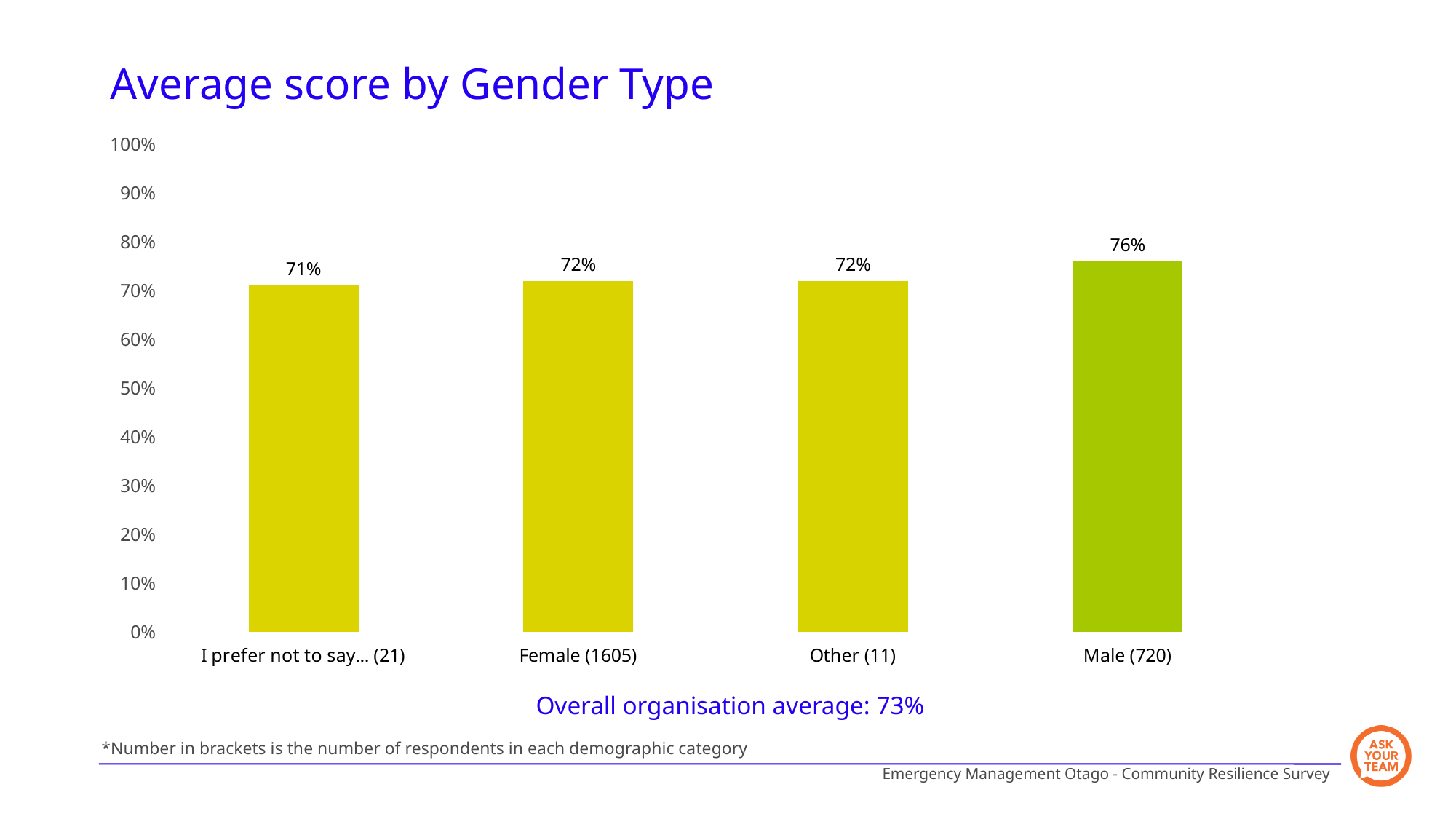
What is the average score for Female (1605)? 72% What is the average score for Male (720)? 76% What is the average score for Other (11)? 72% Which gender category has the lowest average score? I prefer not to say... (21) Which gender category has the highest average score? Male (720) How many gender categories are shown in the chart? 4 Which has a higher average score, Male (720) or I prefer not to say... (21)? Male (720) What is the average score for the 'I prefer not to say... (21)' category? 71% What type of chart is shown on the slide? Bar chart What is the title of the chart? Average score by Gender Type What is the difference between the average score for Male (720) and for Female (1605)? 4% What is the overall organisation average stated on the slide? 73%